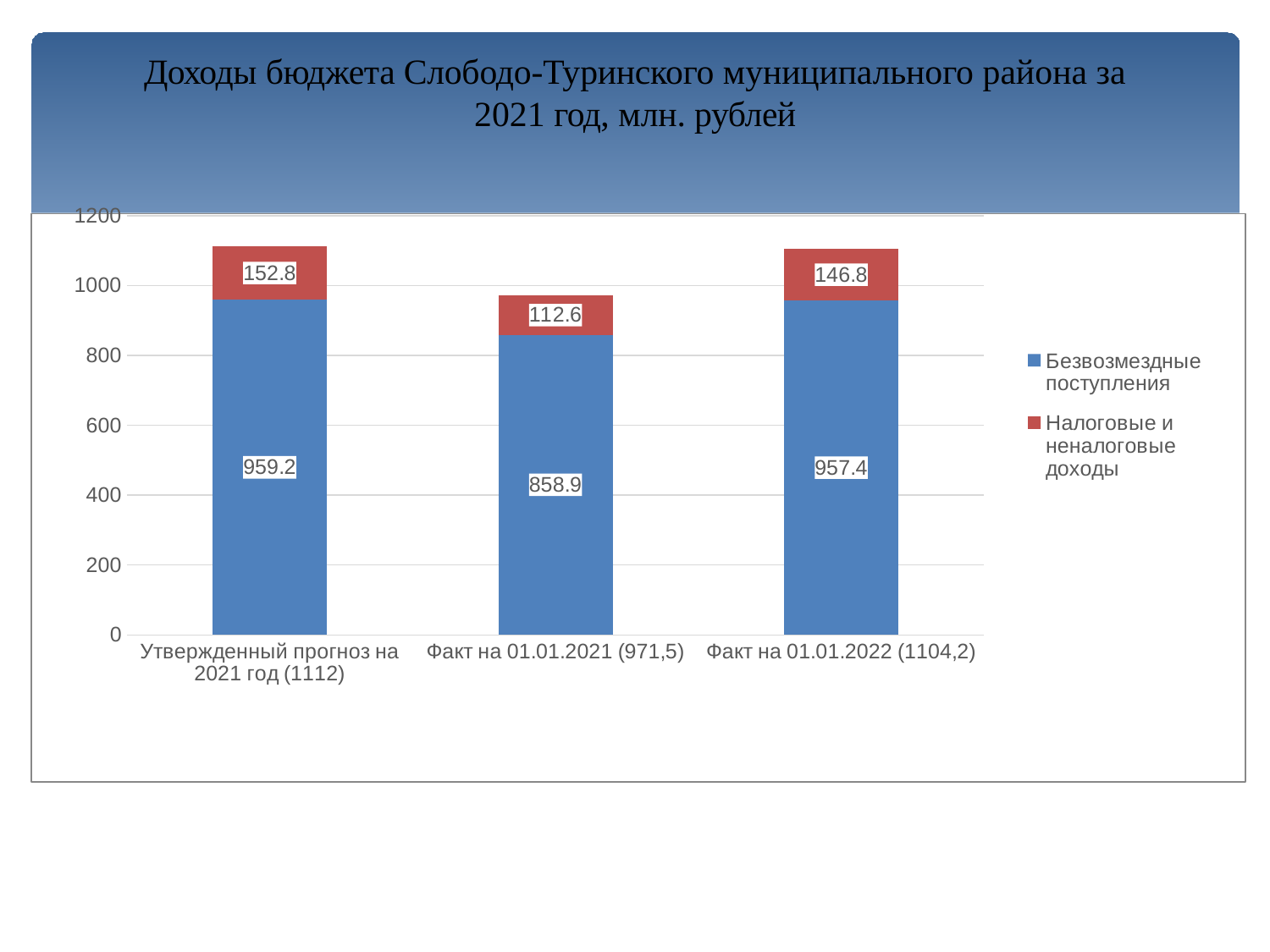
How many categories are shown on the x axis? 3 How many series does the legend list? 2 What is the difference between Безвозмездные поступления for Утвержденный прогноз на 2021 год and for Факт на 01.01.2021? 100.3 What is the value of Налоговые и неналоговые доходы for Факт на 01.01.2022? 146.8 Which category has the lowest value for Безвозмездные поступления? Факт на 01.01.2021 (971,5) What is the value of Налоговые и неналоговые доходы for Факт на 01.01.2021? 112.6 What is the total of the stacked bar for Факт на 01.01.2021? 971.5 What is the difference between Налоговые и неналоговые доходы for Факт на 01.01.2022 and for Факт на 01.01.2021? 34.2 What kind of chart is shown on the slide? Stacked bar chart Which is larger: Безвозмездные поступления for Факт на 01.01.2022 or for Факт на 01.01.2021? Факт на 01.01.2022 Which category has the highest value for Налоговые и неналоговые доходы? Утвержденный прогноз на 2021 год (1112) What is the value of Безвозмездные поступления for Утвержденный прогноз на 2021 год? 959.2